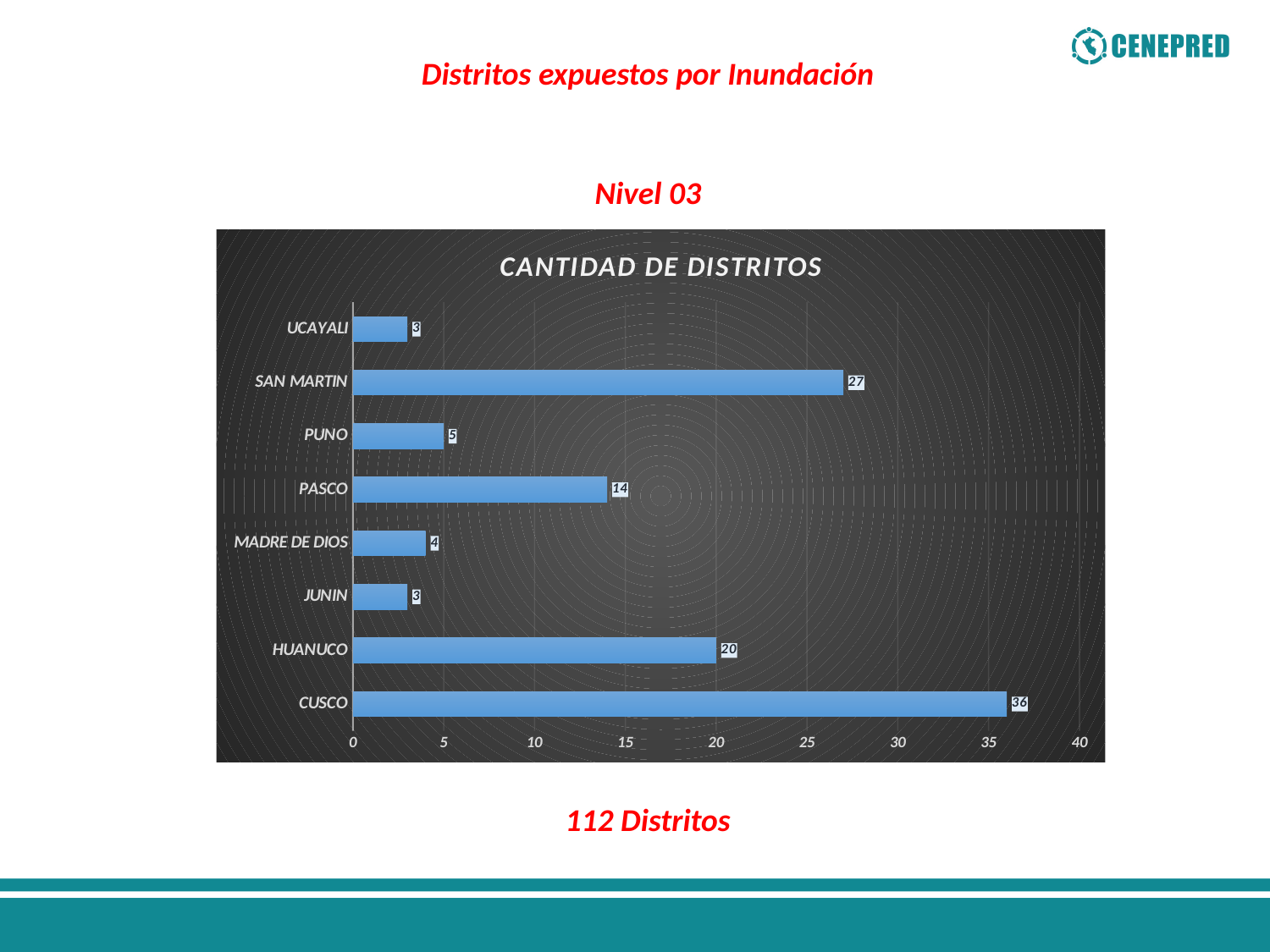
Which is larger, the value for HUANUCO or the value for PASCO? HUANUCO What is the value for SAN MARTIN? 27 What is the title of the chart? CANTIDAD DE DISTRITOS Is the value for SAN MARTIN greater or less than 25? greater What is the value for PASCO? 14 What kind of chart is shown? bar chart How many categories are shown in the chart? 8 Which category has the highest value? CUSCO What is the difference between the values for SAN MARTIN and PASCO? 13 What is the value for CUSCO? 36 What is the difference between the values for CUSCO and HUANUCO? 16 What is the value for MADRE DE DIOS? 4